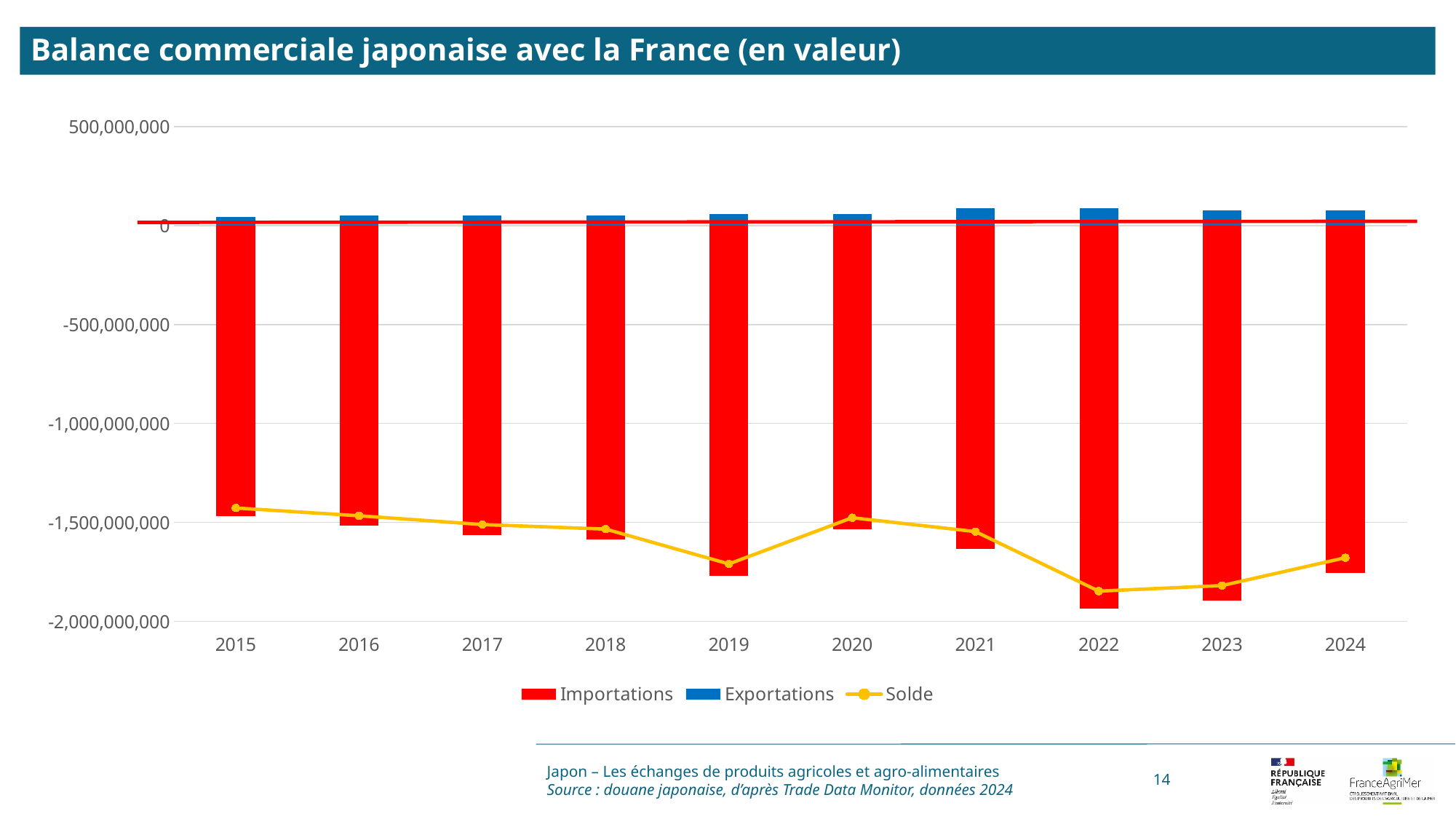
Is the Solde value for 2019 greater or less than -1,500,000,000? less In which year is the Importations bar the shortest (least negative)? 2015 How many series does the legend list? 3 What are the three series named in the legend? Importations, Exportations, Solde What kind of chart is shown on the slide? A bar chart combined with a line In which year does the Solde line reach its highest point? 2015 Is the Importations value for 2022 greater or less than -1,500,000,000? less How many years are shown on the x axis of the chart? 10 In which year is the Importations bar the longest (most negative)? 2022 What colour are the Exportations bars? Blue Is the Importations value for 2015 greater or less than -1,500,000,000? greater Which year has the longer (more negative) Importations bar, 2019 or 2020? 2019